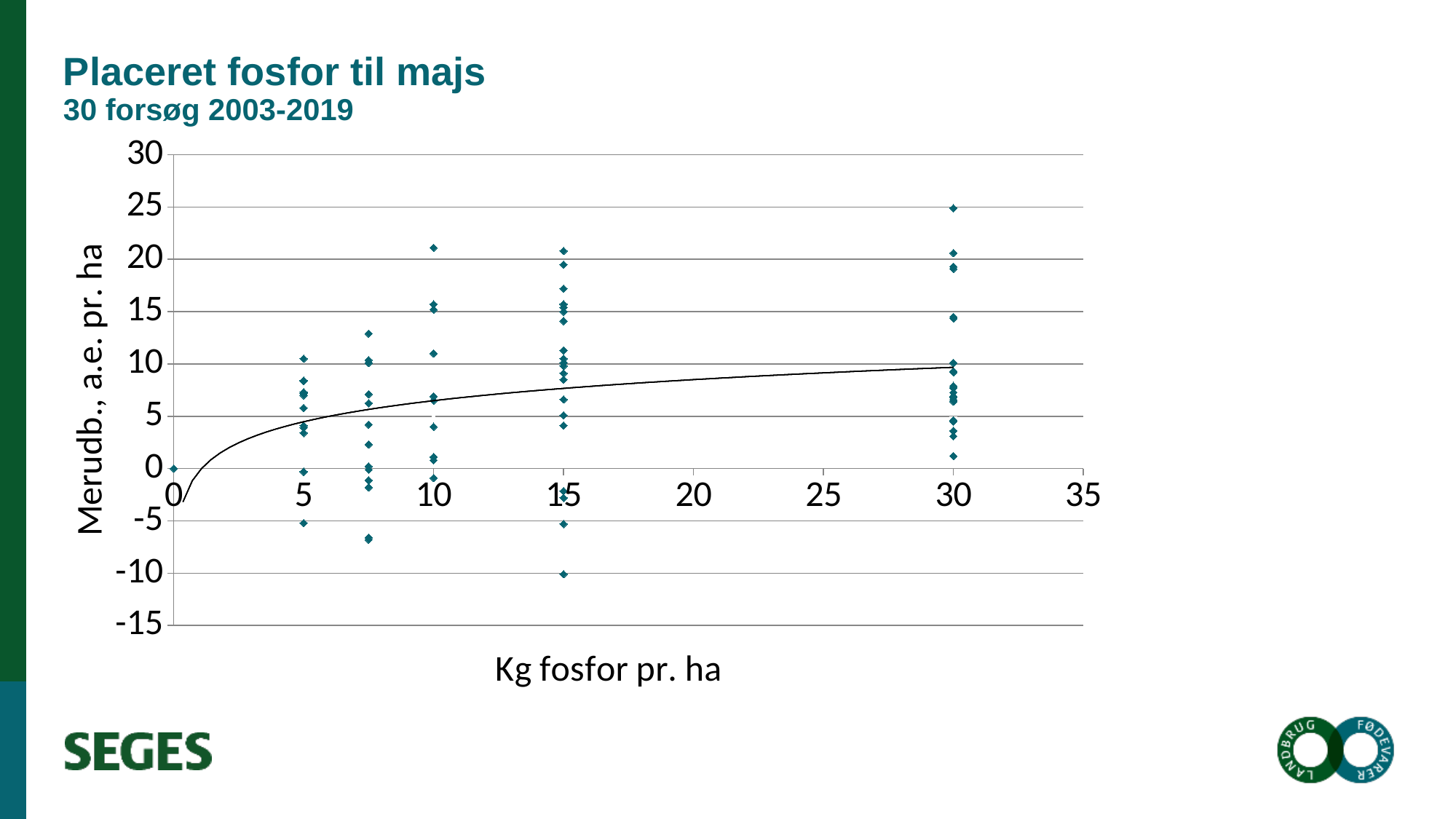
Is the highest data point at 10 Kg fosfor pr. ha greater or less than 20? greater What is the highest value shown on the y axis? 30 Is the value of the fitted curve at 30 Kg fosfor pr. ha greater or less than 15? less What is the title of the chart on the slide? Placeret fosfor til majs Is the lowest data point at 15 Kg fosfor pr. ha greater or less than -5? less At which Kg fosfor pr. ha value is the single highest data point plotted? 30 Does the fitted curve rise or fall as Kg fosfor pr. ha increases? Rises What kind of chart is shown on the slide? Scatter plot What is the label of the x axis? Kg fosfor pr. ha At which Kg fosfor pr. ha value is the single lowest data point plotted? 15